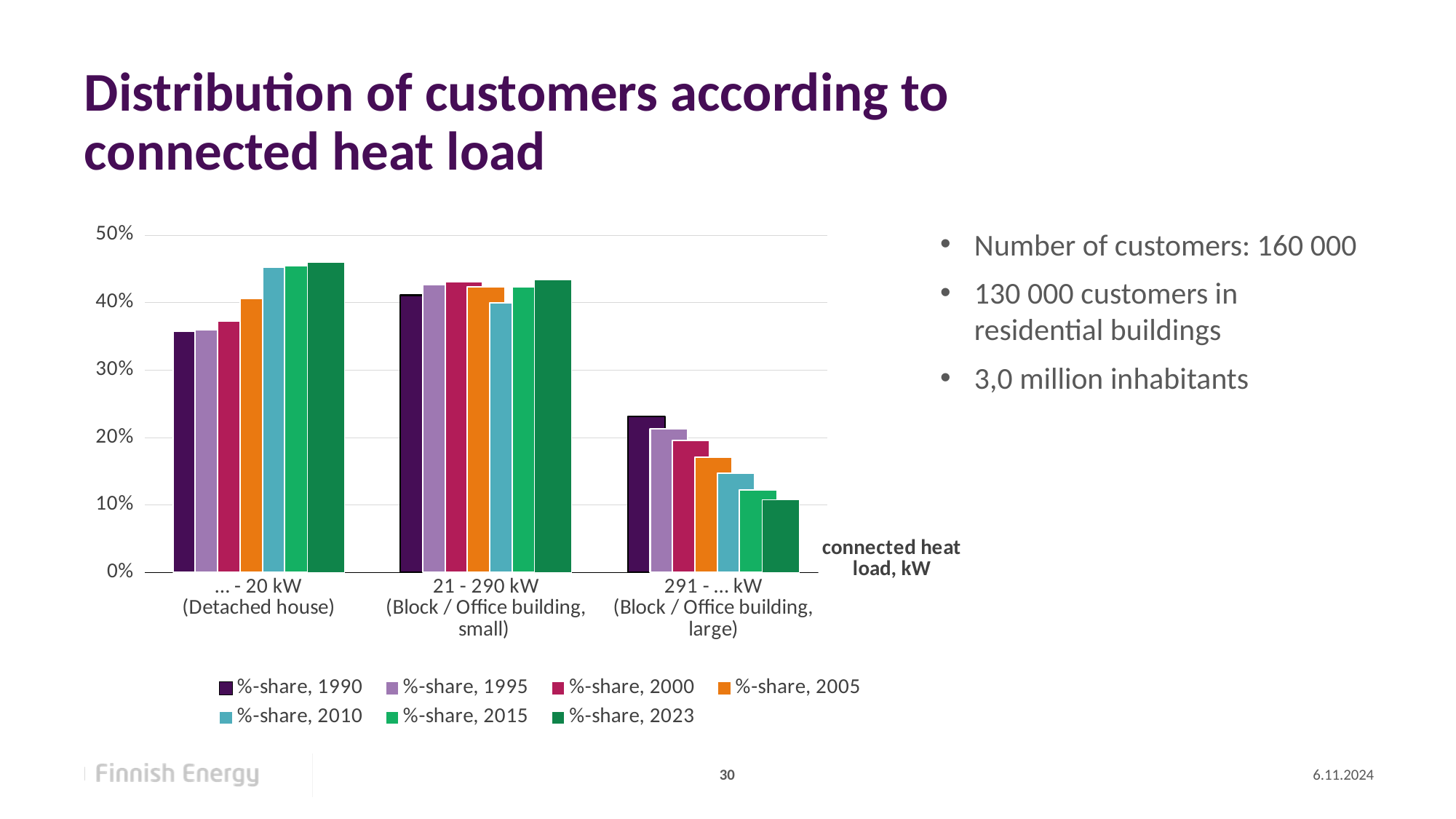
How many connected heat load categories are shown on the x axis? 3 How many series does the legend list? 7 For the "... - 20 kW" category, do the values rise or fall from 1990 to 2023? rise For the "291 - ... kW" category, do the values rise or fall from 1990 to 2023? fall Is the %-share, 2023 value for the "... - 20 kW" category greater or less than 40%? greater Is the %-share, 2023 value for the "291 - ... kW" category greater or less than 20%? less Is the %-share, 1990 value for the "291 - ... kW" category greater or less than 20%? greater What kind of chart is shown on the slide? bar chart Which category has the highest %-share, 1990 value? 21 - 290 kW (Block / Office building, small) In the "291 - ... kW" category, which is larger: the %-share for 1990 or for 2023? %-share, 1990